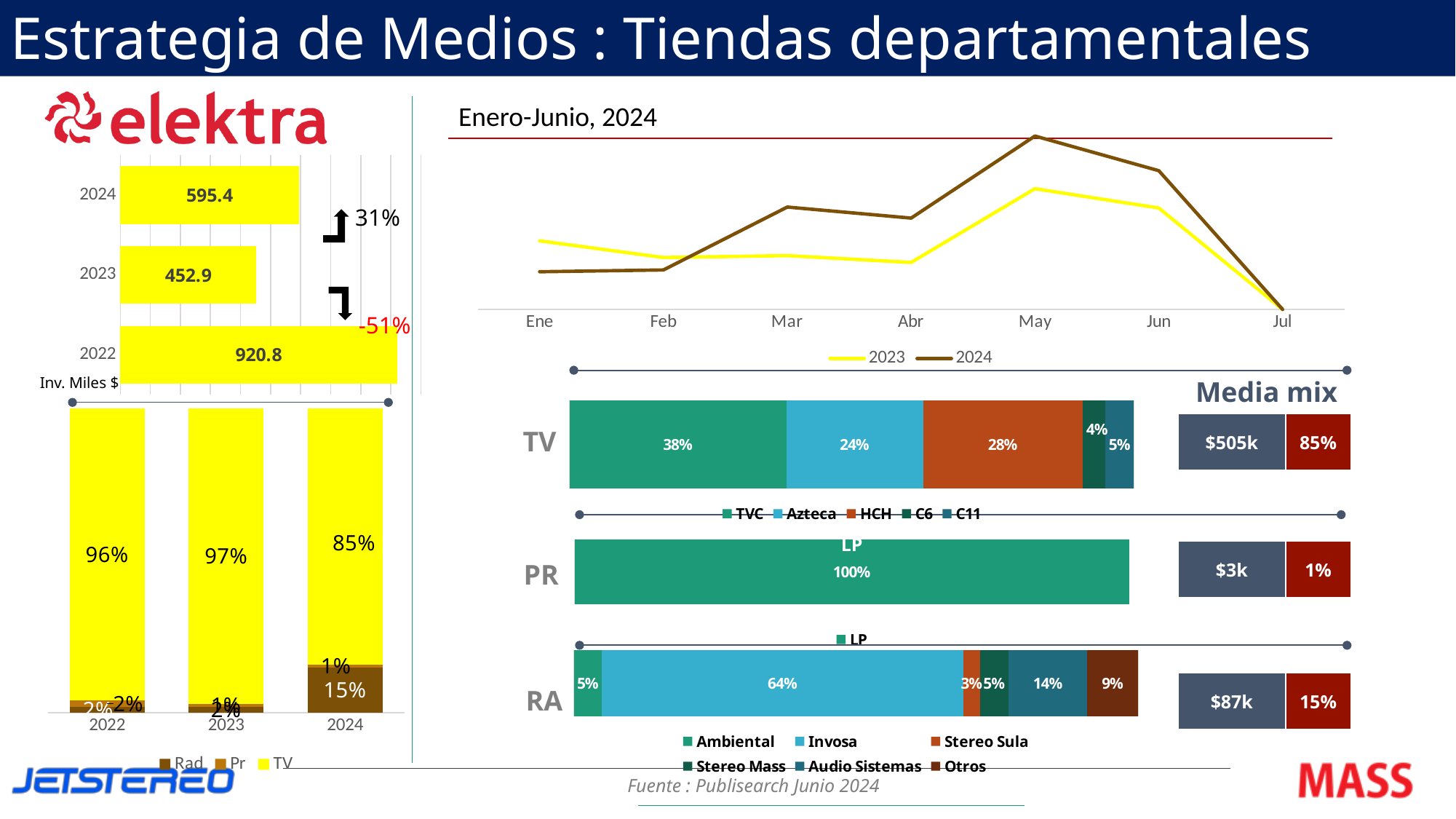
In the Media mix boxes, what is the dollar amount shown for TV? $505k What kind of chart is the Enero-Junio, 2024 chart at the top right? line chart In the investment bar chart on the left (Inv. Miles $), what is the value for 2024? 595.4 In the Enero-Junio, 2024 line chart, does the 2024 line rise or fall from May to Jul? fall In the investment bar chart on the left (Inv. Miles $), which year has the highest value? 2022 In the stacked bar chart at the bottom left, what share does Rad have in 2024? 15% In the investment bar chart on the left (Inv. Miles $), what is the difference between the 2022 and 2023 values? 467.9 In the TV stacked bar, what share does TVC have? 38% In the TV stacked bar, what is the difference between the HCH and Azteca shares? 4% How many series does the legend of the Enero-Junio, 2024 line chart list? 2 In the RA stacked bar, which is larger, Audio Sistemas or Otros? Audio Sistemas In the stacked bar chart at the bottom left, what share does TV have in 2024? 85%